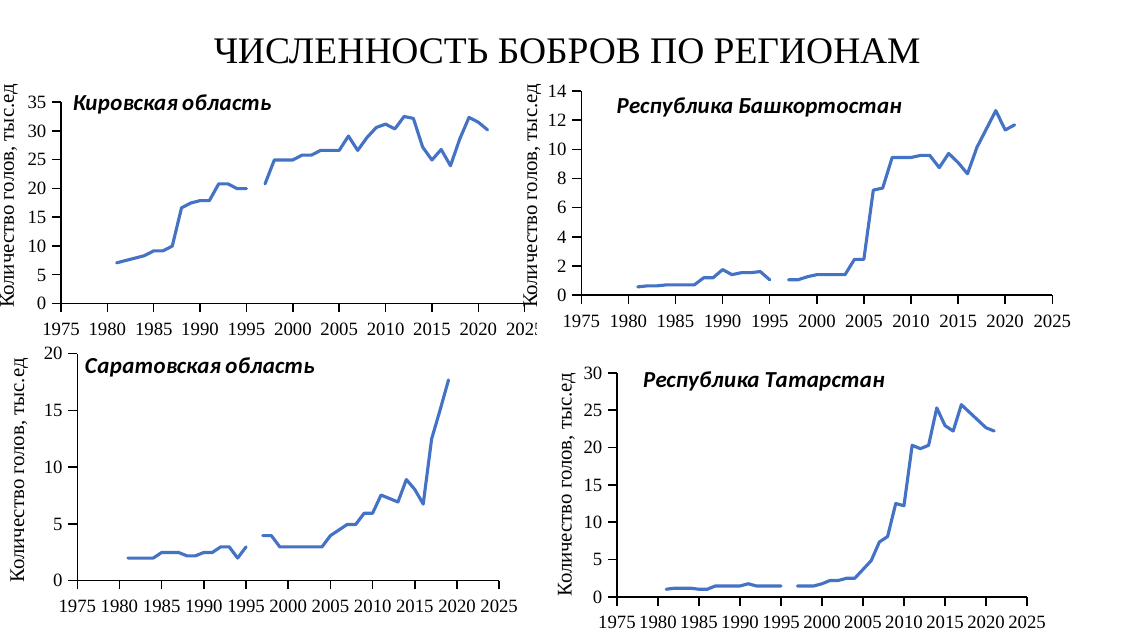
In the Саратовская область chart, in which year is the value highest? 2019 In the Республика Башкортостан chart, which is larger, the value for 1990 or the value for 2010? 2010 In the Кировская область chart, which is larger, the value for 1985 or the value for 2010? 2010 In the Саратовская область chart, is the value for 1985 greater or less than 5? less In the Республика Башкортостан chart, is the value for 2000 greater or less than 2? less What is the title of the slide? ЧИСЛЕННОСТЬ БОБРОВ ПО РЕГИОНАМ In the Республика Башкортостан chart, is the value for 2019 greater or less than 10? greater In the Республика Татарстан chart, do the values rise or fall between 2005 and 2015? rise What kind of chart is used for Кировская область? line chart In the Кировская область chart, do the values generally rise or fall from 1980 to 2020? rise